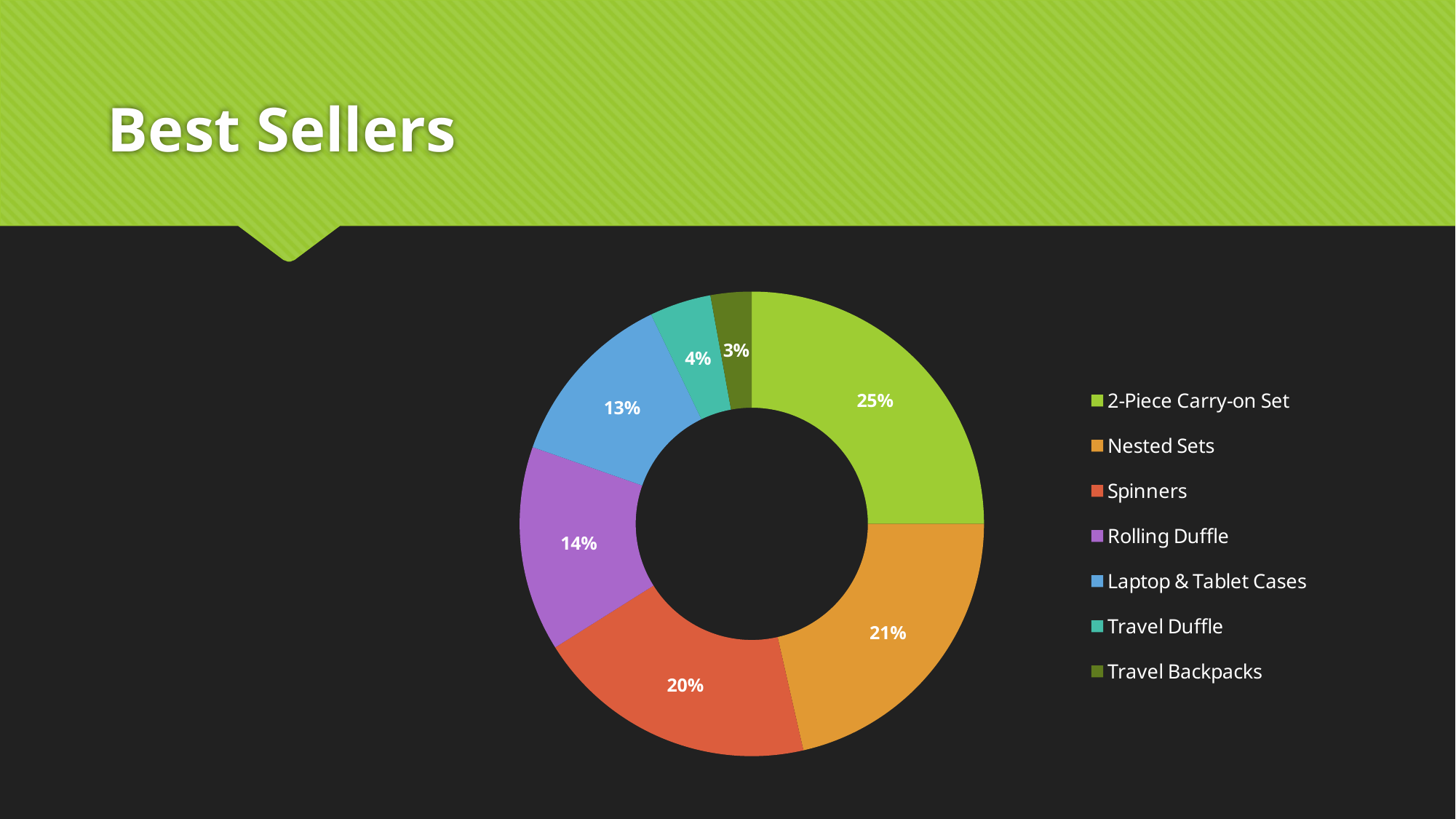
What colour is the Rolling Duffle slice? Purple What kind of chart is shown on the slide? Doughnut chart Which category has the smallest slice? Travel Backpacks Which is larger, Nested Sets or Spinners? Nested Sets What is the value shown for Spinners? 20% Which category has the largest slice? 2-Piece Carry-on Set What is the combined share of Travel Duffle and Travel Backpacks? 7% What is the value shown for Laptop & Tablet Cases? 13% What share of the chart does the 2-Piece Carry-on Set slice represent? 25% How many categories are shown in the chart? 7 What is the difference between the Rolling Duffle and Travel Duffle values? 10% What is the value shown for Nested Sets? 21%